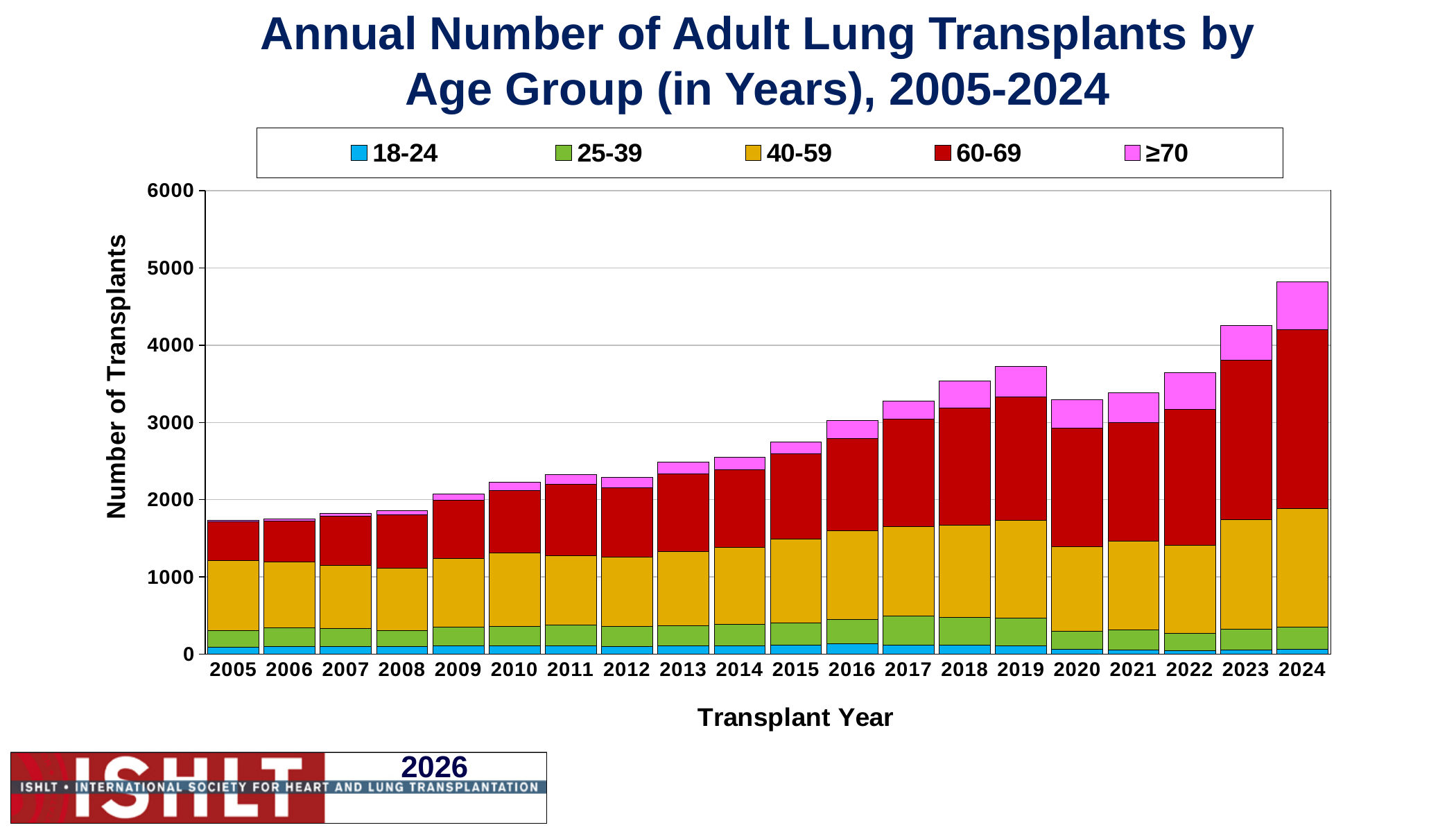
Is the total number of transplants in 2024 greater or less than 4000? greater What kind of chart is shown on the slide? Stacked bar chart Overall, do the total annual transplant numbers rise or fall from 2005 to 2024? rise Is the total number of transplants in 2019 greater or less than 3000? greater How many age-group series does the legend list? 5 What is the title of the chart? Annual Number of Adult Lung Transplants by Age Group (in Years), 2005-2024 Which year has a larger total number of transplants, 2019 or 2020? 2019 Is the total number of transplants in 2015 greater or less than 3000? less Which colour represents the 60-69 age group in the legend? Red Which transplant year has the highest total number of adult lung transplants? 2024 How many transplant years are shown along the x axis? 20